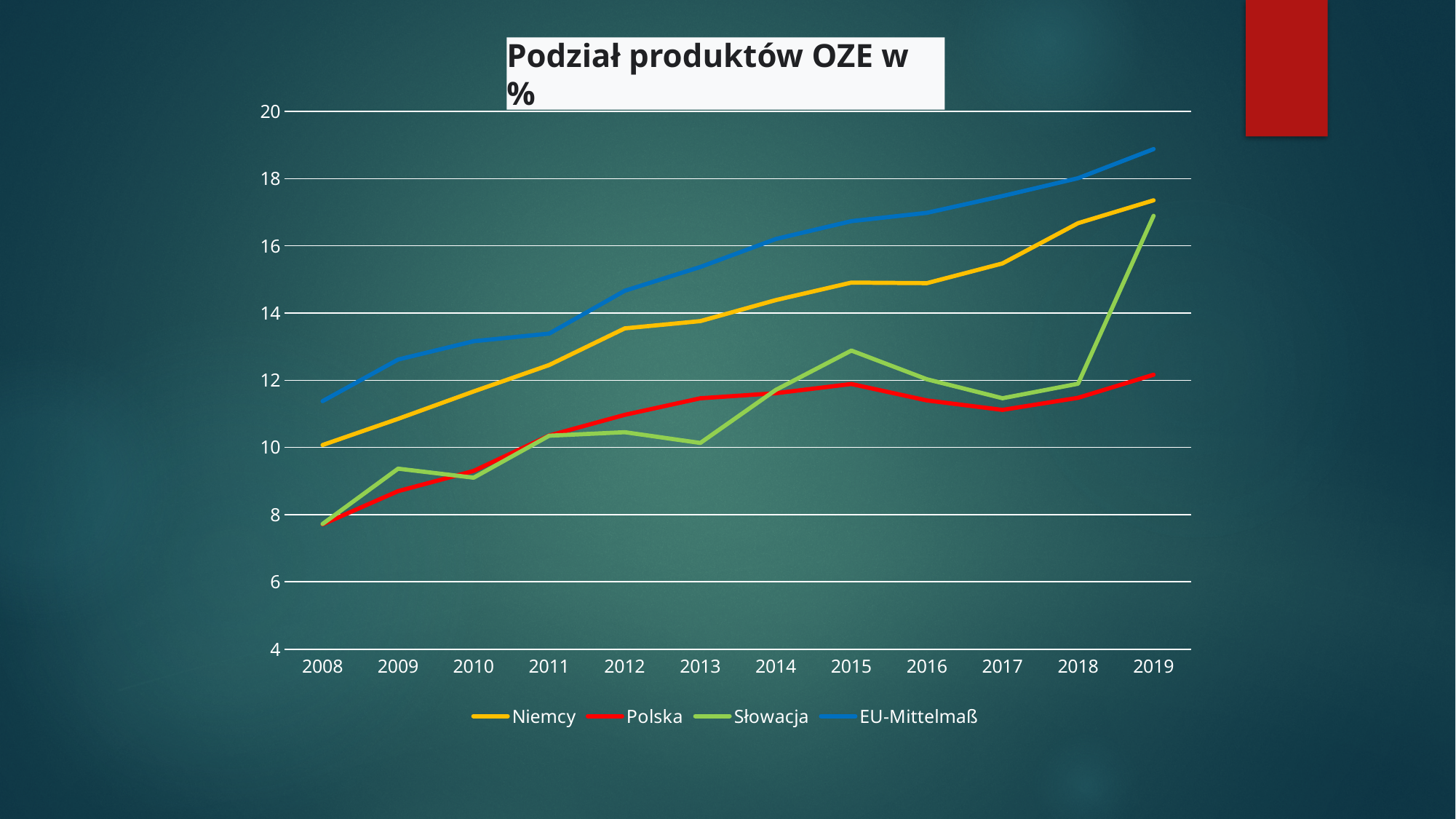
What is the title of the chart? Podział produktów OZE w % Which series has the lowest value in 2019? Polska Does the EU-Mittelmaß line rise or fall from 2008 to 2019? rise In 2015, which is larger: the value for Słowacja or the value for Polska? Słowacja Is the value for Niemcy in 2008 greater or less than 12? less How many series does the legend list? 4 What kind of chart is shown on the slide? line chart Which series has the highest value in 2019? EU-Mittelmaß Is the value for Polska in 2019 greater or less than 14? less Is the value for Słowacja in 2019 greater or less than 16? greater How many years are shown on the x axis? 12